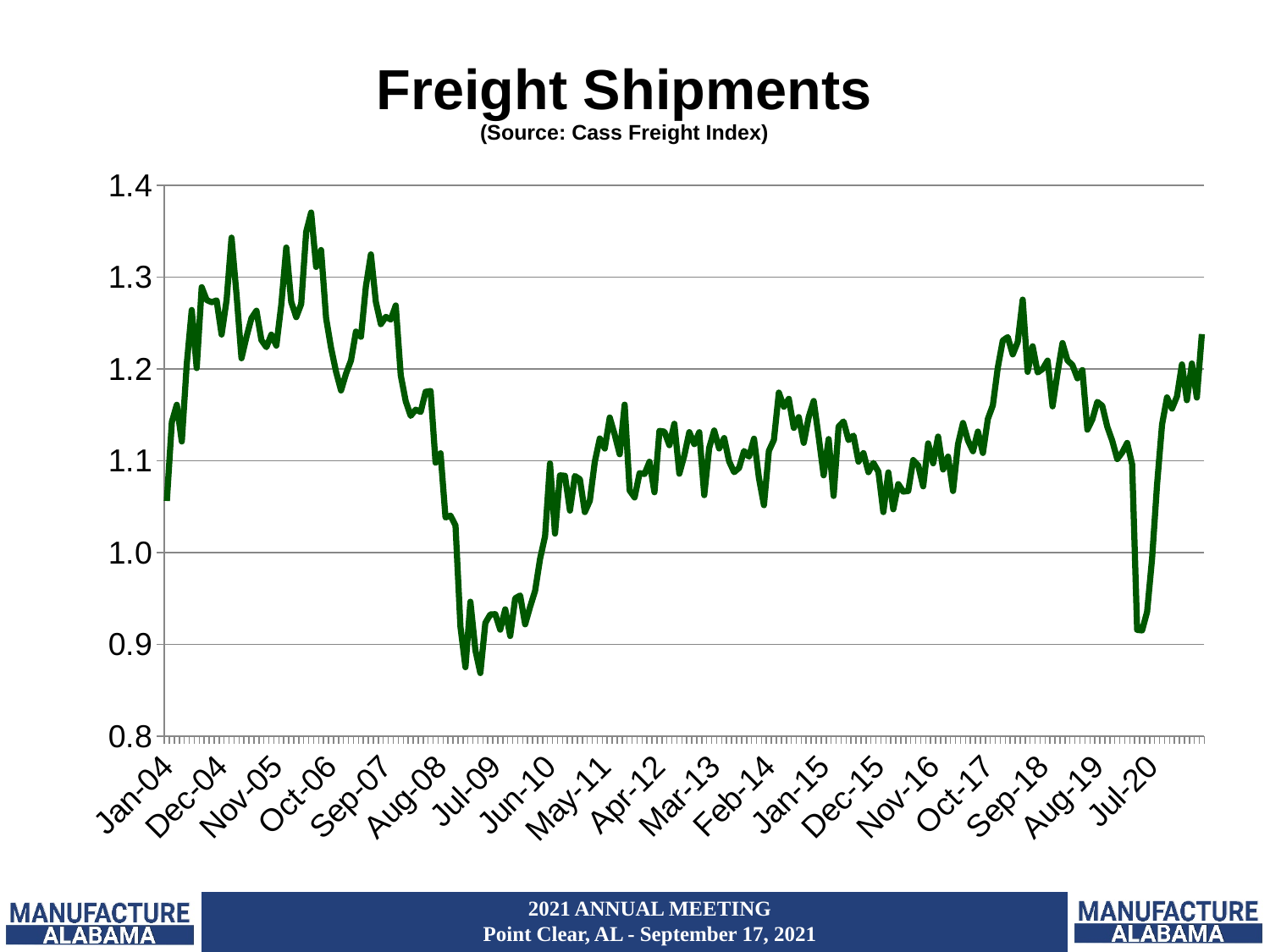
Does the line rise or fall between Oct-06 and Jul-09? fall How many date labels are shown on the x axis? 19 What is the title of the chart? Freight Shipments Near which x-axis label does the line reach its highest point? Oct-06 What source is cited for the chart data? Cass Freight Index Is the value at Jan-04 greater or less than 1.0? greater Is the lowest value near Jul-09 greater or less than 1.0? less Is the dip in the line near Jul-20 greater or less than 1.0? less Near which x-axis label does the line reach its lowest point? Jul-09 What kind of chart is shown on the slide? line chart